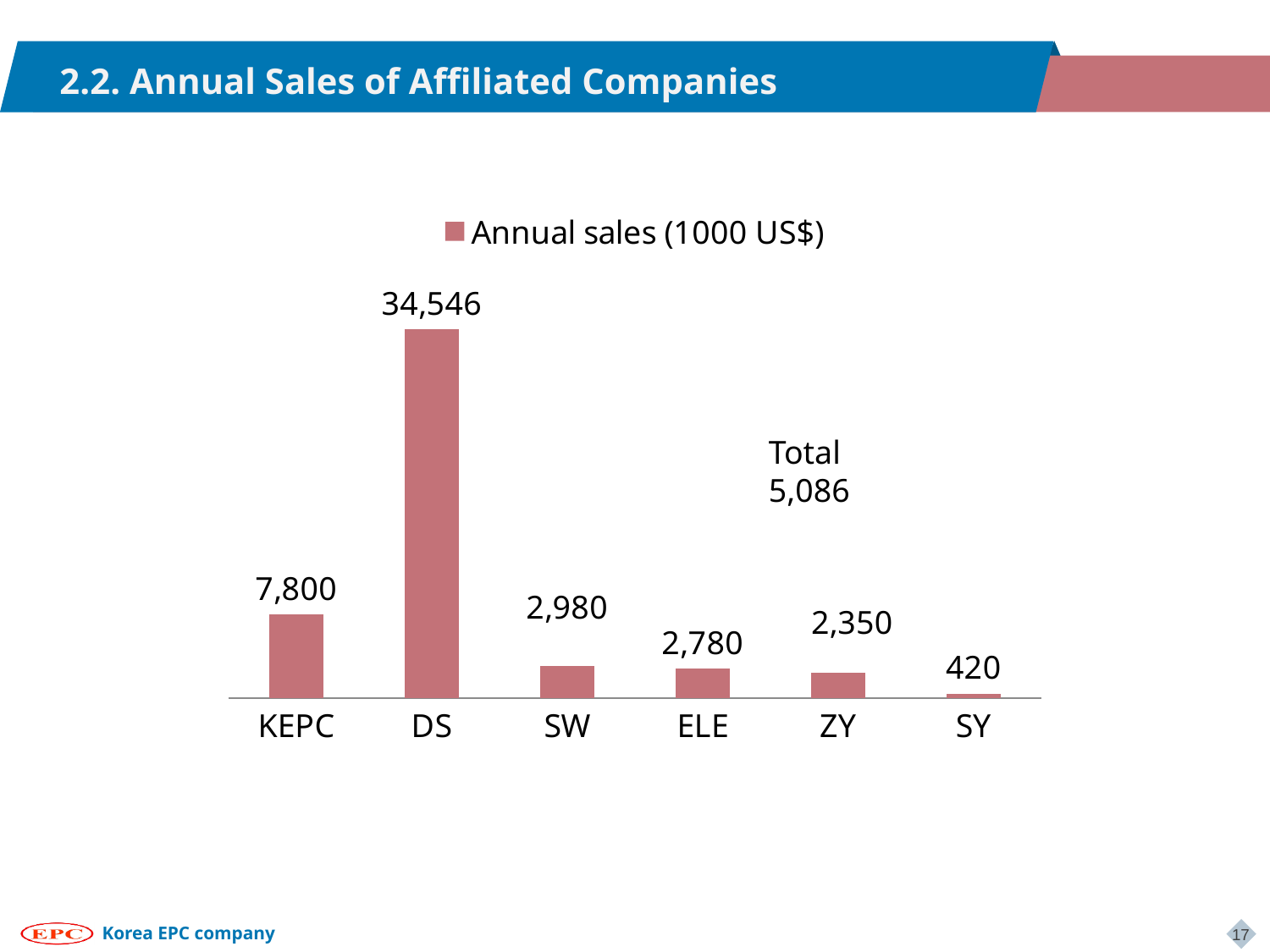
What is the annual sales value for KEPC? 7,800 What is the difference between the annual sales of DS and KEPC? 26,746 What is the annual sales value for SY? 420 What is the legend entry of the series shown in the chart? Annual sales (1000 US$) Which has higher annual sales, SW or ELE? SW How many companies are shown on the x axis? 6 What is the difference between the annual sales of SW and ZY? 630 What is the annual sales value for ELE? 2,780 What kind of chart is shown on the slide? Bar chart Which company has the lowest annual sales? SY What is the annual sales value for DS? 34,546 Which company has the highest annual sales? DS